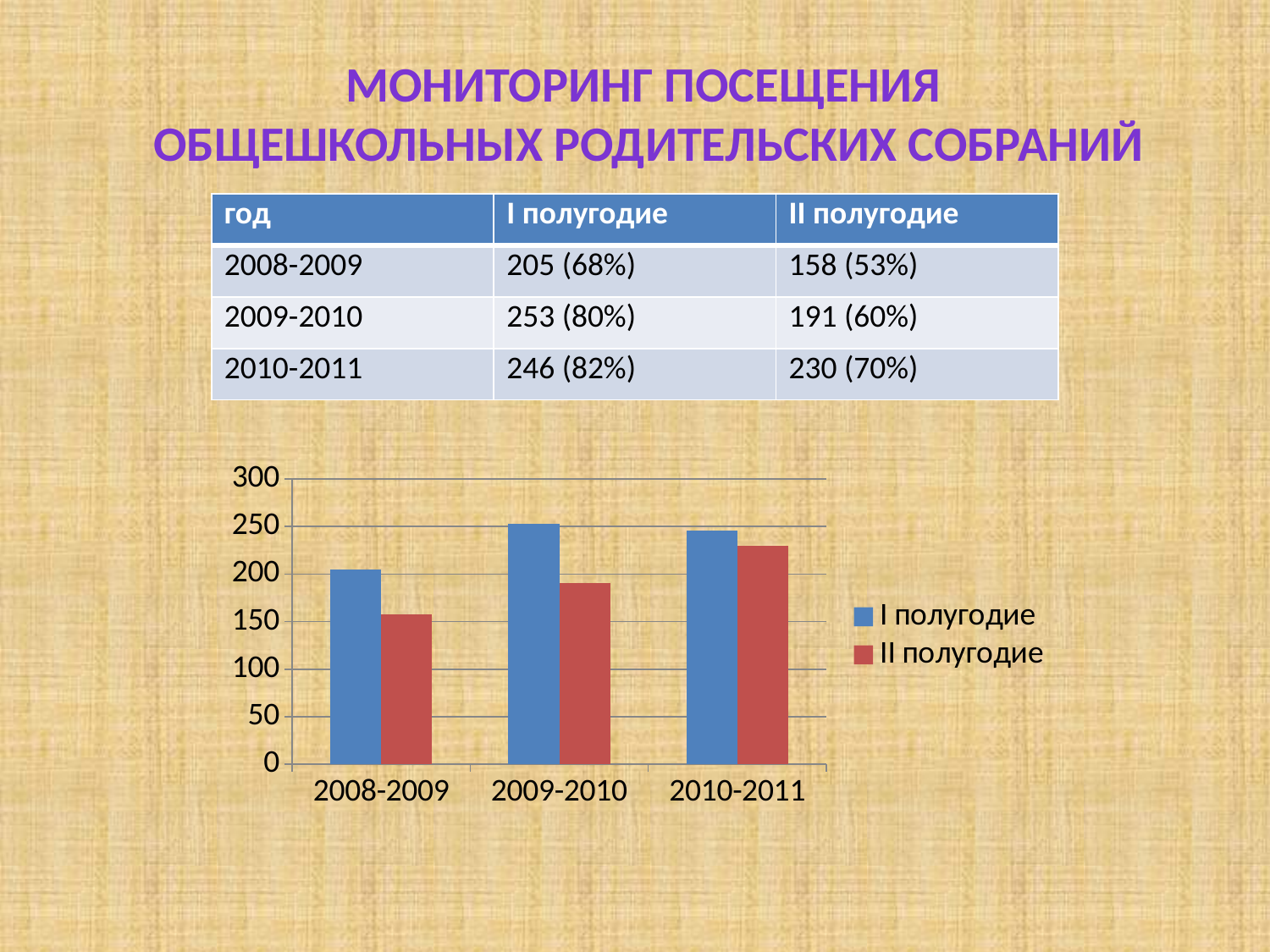
Is the value for II полугодие in 2010-2011 greater or less than 200? greater Which year has the highest value for I полугодие? 2009-2010 What kind of chart is shown on the slide? bar chart In 2010-2011, which is larger: I полугодие or II полугодие? I полугодие According to the table on the slide, what is the value for I полугодие in 2008-2009? 205 (68%) Is the value for I полугодие in 2009-2010 greater or less than 250? greater Which year has the lowest value for II полугодие? 2008-2009 Do the values for II полугодие rise or fall from 2008-2009 to 2010-2011? rise How many year categories are shown on the x axis of the chart? 3 How many series does the chart legend list? 2 Is the value for II полугодие in 2008-2009 greater or less than 200? less Which colour represents II полугодие in the chart? red